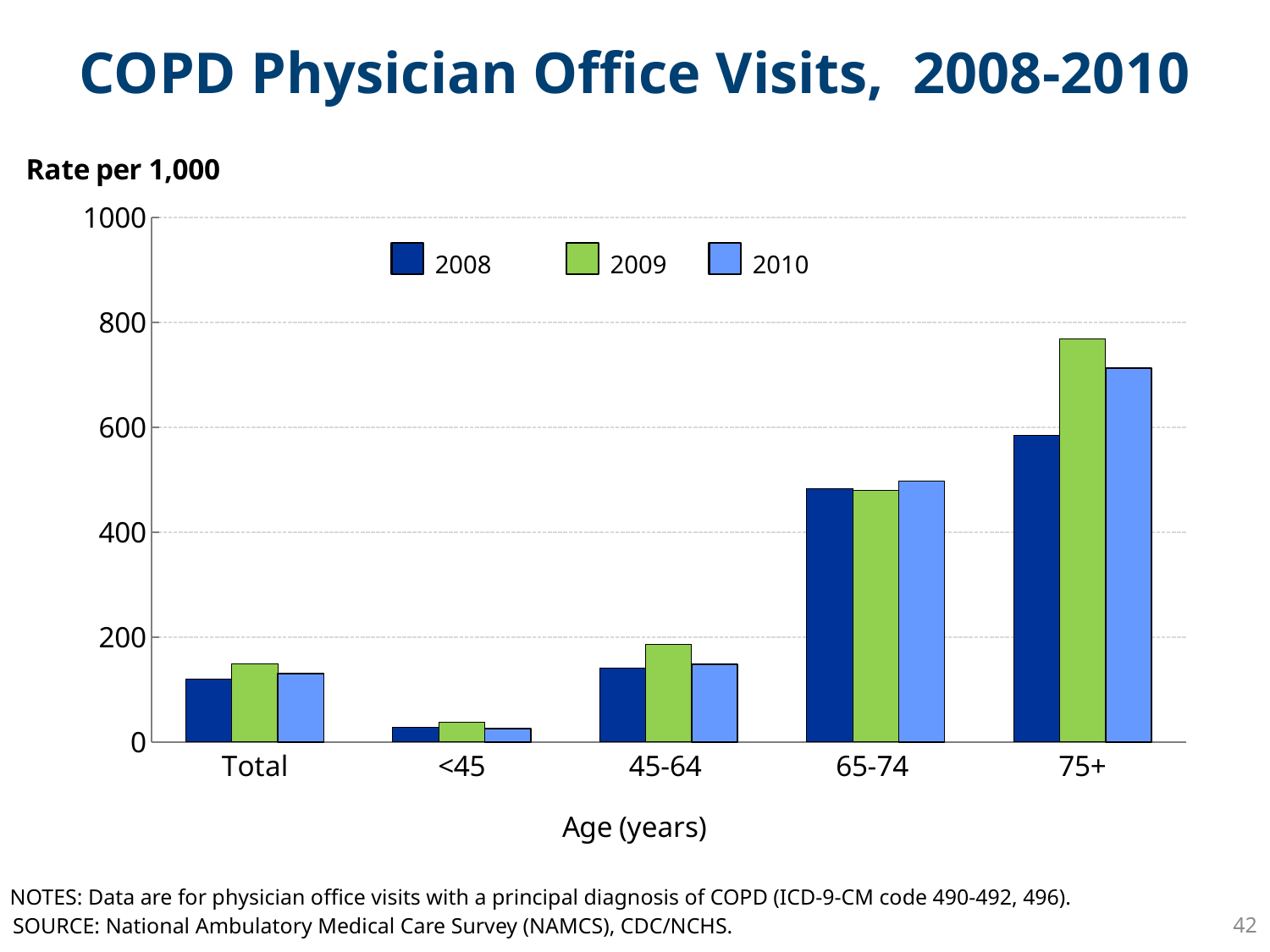
For the 45-64 age group, which is larger: the 2008 value or the 2009 value? 2009 What is the label of the x axis? Age (years) Which age category has the highest 2009 value? 75+ How many age categories are shown on the x axis? 5 How many series does the legend list? 3 Is the 2010 value for the 65-74 age group greater or less than 600? less Which age category has the lowest 2008 value? <45 For the 75+ age group, which is larger: the 2009 value or the 2010 value? 2009 Is the 2009 value for the Total category greater or less than 200? less What kind of chart is shown on the slide? bar chart Is the 2009 value for the 75+ age group greater or less than 600? greater Do the 2010 values rise or fall moving from the <45 age group to the 75+ age group? rise